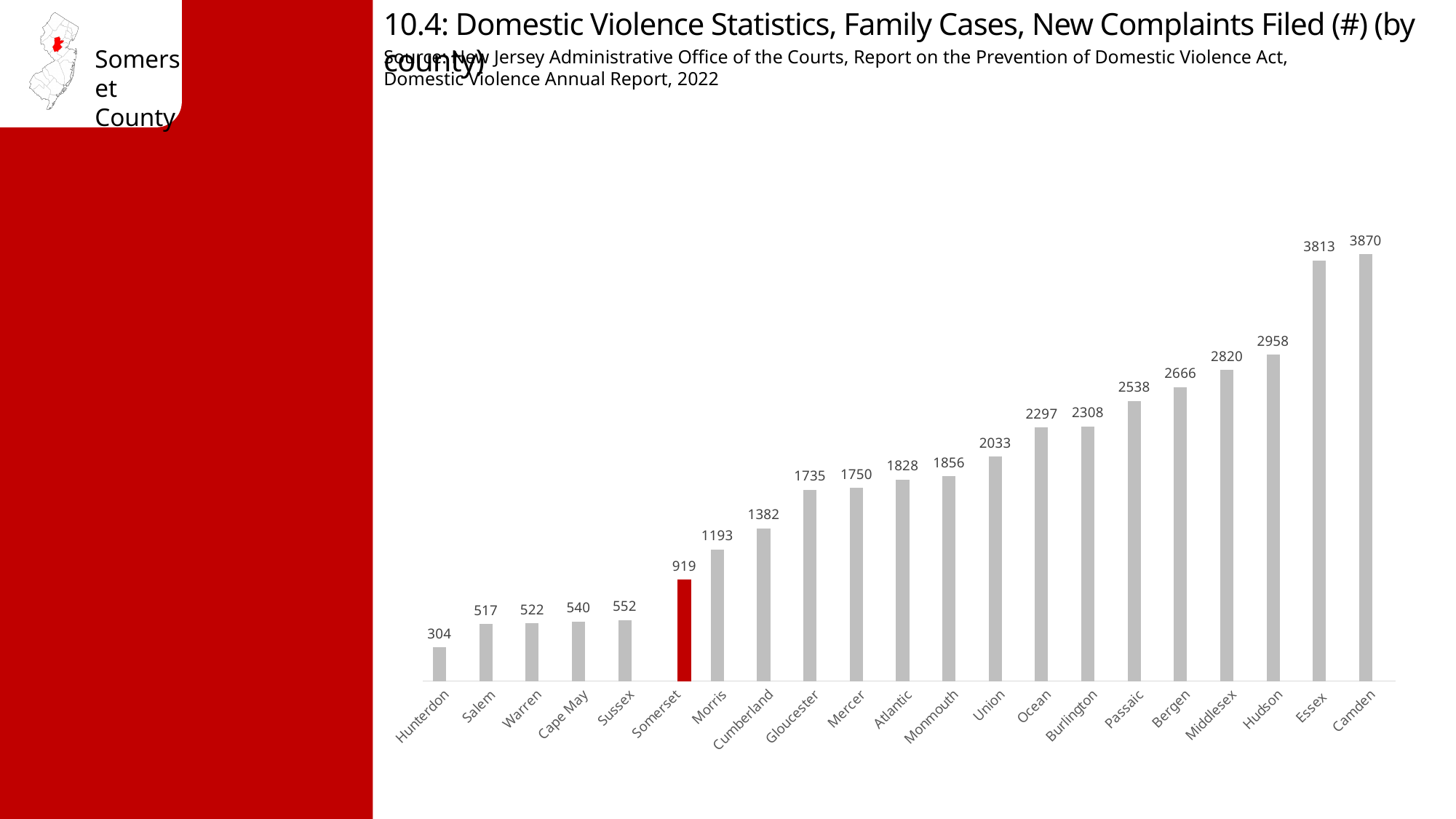
What is the value shown for Cape May? 540 What is the number of new domestic violence complaints filed for Somerset? 919 What kind of chart is shown on the slide? Bar chart Which county has the highest number of new complaints filed? Camden Which county's bar is highlighted in red? Somerset What is the value shown for Hudson? 2958 Which has a larger value, Morris or Cumberland? Cumberland What is the difference between the values for Somerset and Hunterdon? 615 Do the values rise or fall from left to right along the x axis? Rise What is the difference between the values for Camden and Essex? 57 Which county has the lowest number of new complaints filed? Hunterdon How many counties are shown on the chart? 21